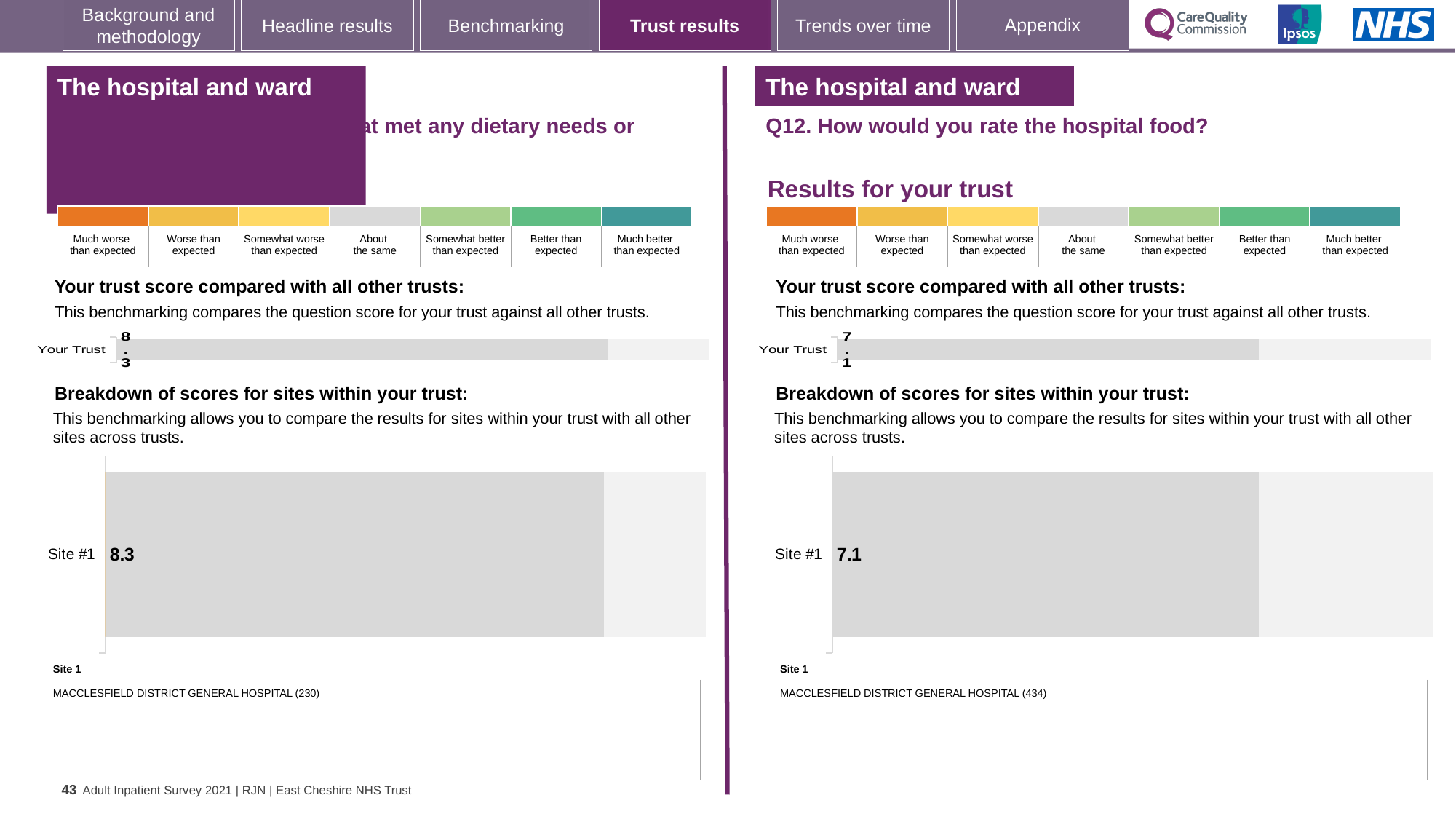
On the left-hand panel, what number of respondents is shown in brackets after MACCLESFIELD DISTRICT GENERAL HOSPITAL for Site 1? 230 What is the difference between the Site #1 score on the left-hand panel (8.3) and the Site #1 score on the right-hand panel (7.1)? 1.2 How many sites are shown in the breakdown of scores chart on the right-hand panel (Q12)? 1 Which is larger: the Site #1 score on the left-hand panel or the Site #1 score on the right-hand panel (Q12)? Left-hand panel (8.3) On the left-hand panel, what score is shown for Site #1 in the breakdown of scores for sites within your trust? 8.3 How many sites are shown in the breakdown of scores chart on the left-hand panel? 1 On the right-hand panel (Q12. How would you rate the hospital food?), what is the score shown for Your Trust? 7.1 Is the Your Trust score on the right-hand panel (Q12) greater or less than the Your Trust score on the left-hand panel? less What type of chart is used to show the Site #1 score on the right-hand panel (Q12)? Bar chart On the left-hand panel, what is the score shown for Your Trust? 8.3 On the right-hand panel (Q12), what score is shown for Site #1 in the breakdown of scores for sites within your trust? 7.1 On the right-hand panel (Q12), which hospital is listed as Site 1 below the chart? MACCLESFIELD DISTRICT GENERAL HOSPITAL (434)